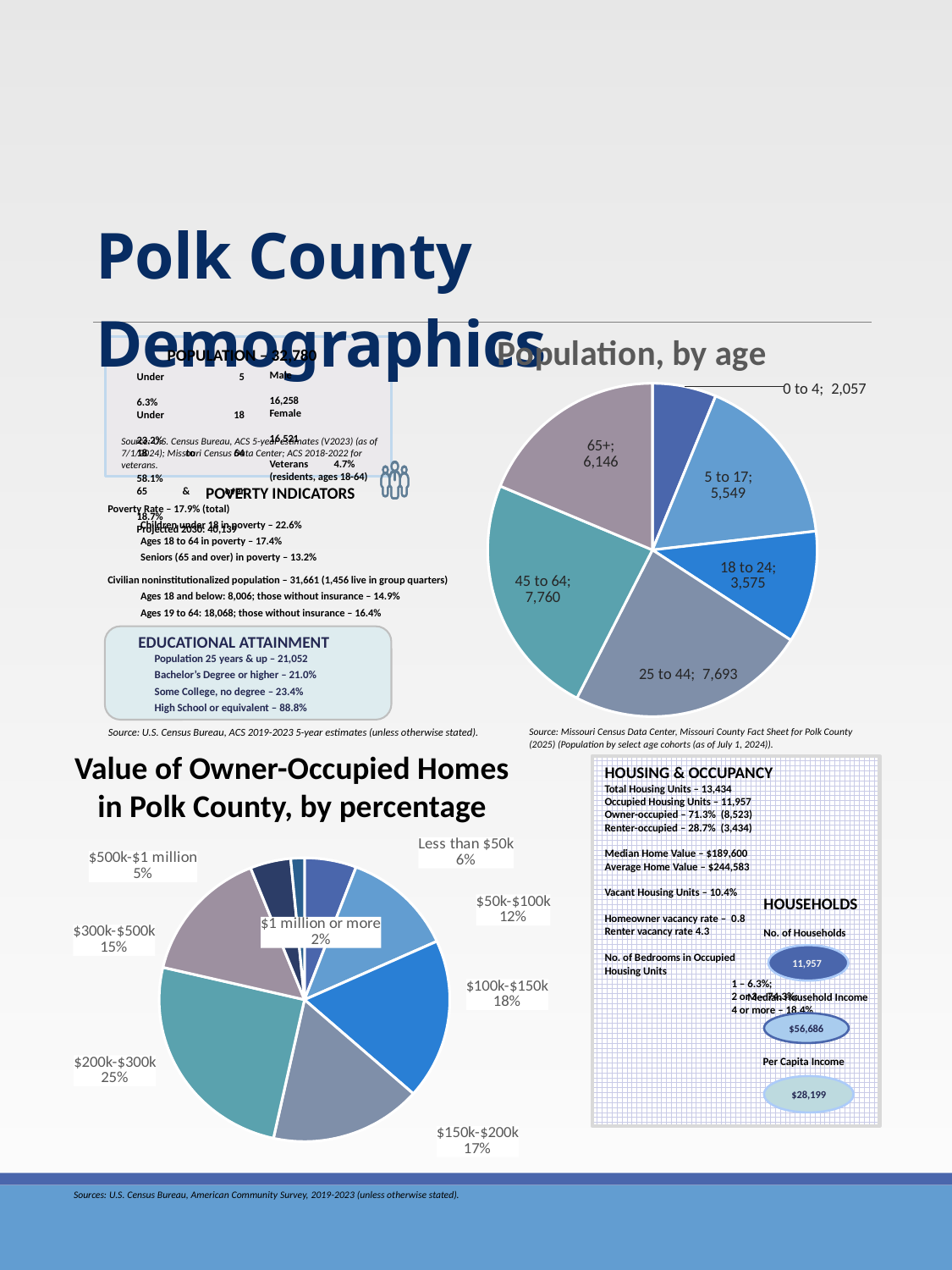
In the 'Value of Owner-Occupied Homes in Polk County, by percentage' chart, which is larger: $100k-$150k or $150k-$200k? $100k-$150k In the 'Value of Owner-Occupied Homes in Polk County, by percentage' chart, which value range has the largest share? $200k-$300k In the 'Value of Owner-Occupied Homes in Polk County, by percentage' chart, how many value ranges are shown? 8 In the 'Population, by age' pie chart, what is the value for the 25 to 44 age group? 7,693 What type of chart is 'Population, by age'? Pie chart In the 'Value of Owner-Occupied Homes in Polk County, by percentage' chart, what percentage of homes are valued at $200k-$300k? 25% In the 'Population, by age' pie chart, which age group has the largest population? 45 to 64 In the 'Population, by age' pie chart, what is the difference between the 5 to 17 and 18 to 24 age groups? 1,974 In the 'Population, by age' pie chart, which age group has the smallest population? 0 to 4 In the 'Population, by age' pie chart, what is the value for the 65+ age group? 6,146 In the 'Population, by age' pie chart, how many age groups are shown? 6 In the 'Value of Owner-Occupied Homes in Polk County, by percentage' chart, what percentage of homes are valued at $1 million or more? 2%